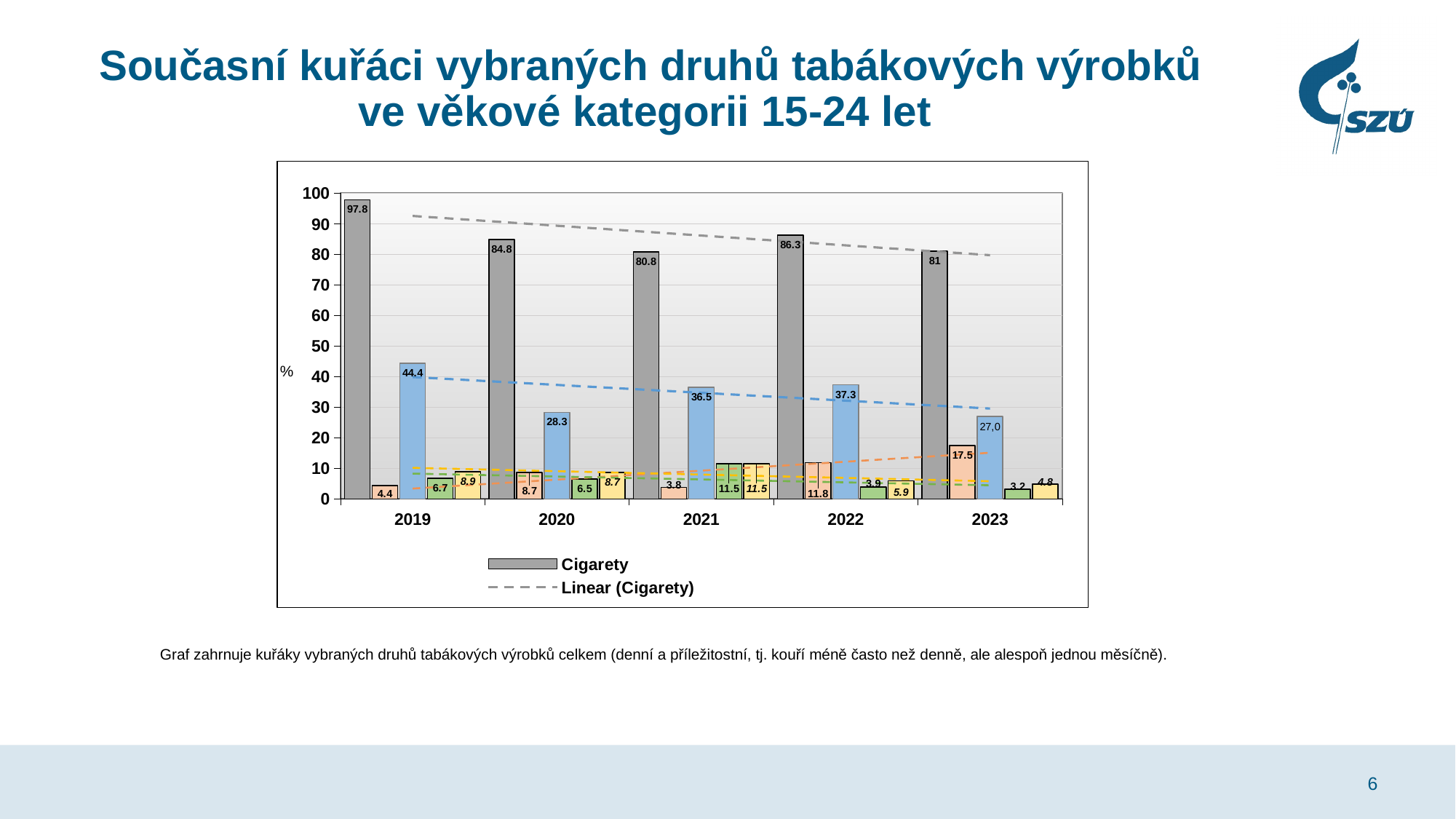
What is the difference between the Cigarety values for 2019 and 2020? 13 Which year has the larger Cigarety value, 2020 or 2022? 2022 What entries does the legend list? Cigarety, Linear (Cigarety) Does the Linear (Cigarety) trend line rise or fall from 2019 to 2023? fall What is the value for Cigarety in 2021? 80.8 What kind of chart is shown on the slide? bar chart What is the value for Cigarety in 2019? 97.8 In which year is the Cigarety value highest? 2019 What unit is shown on the y axis? % Is the Cigarety value for 2023 greater or less than 80? greater What is the value for Cigarety in 2022? 86.3 How many years are shown on the x axis? 5